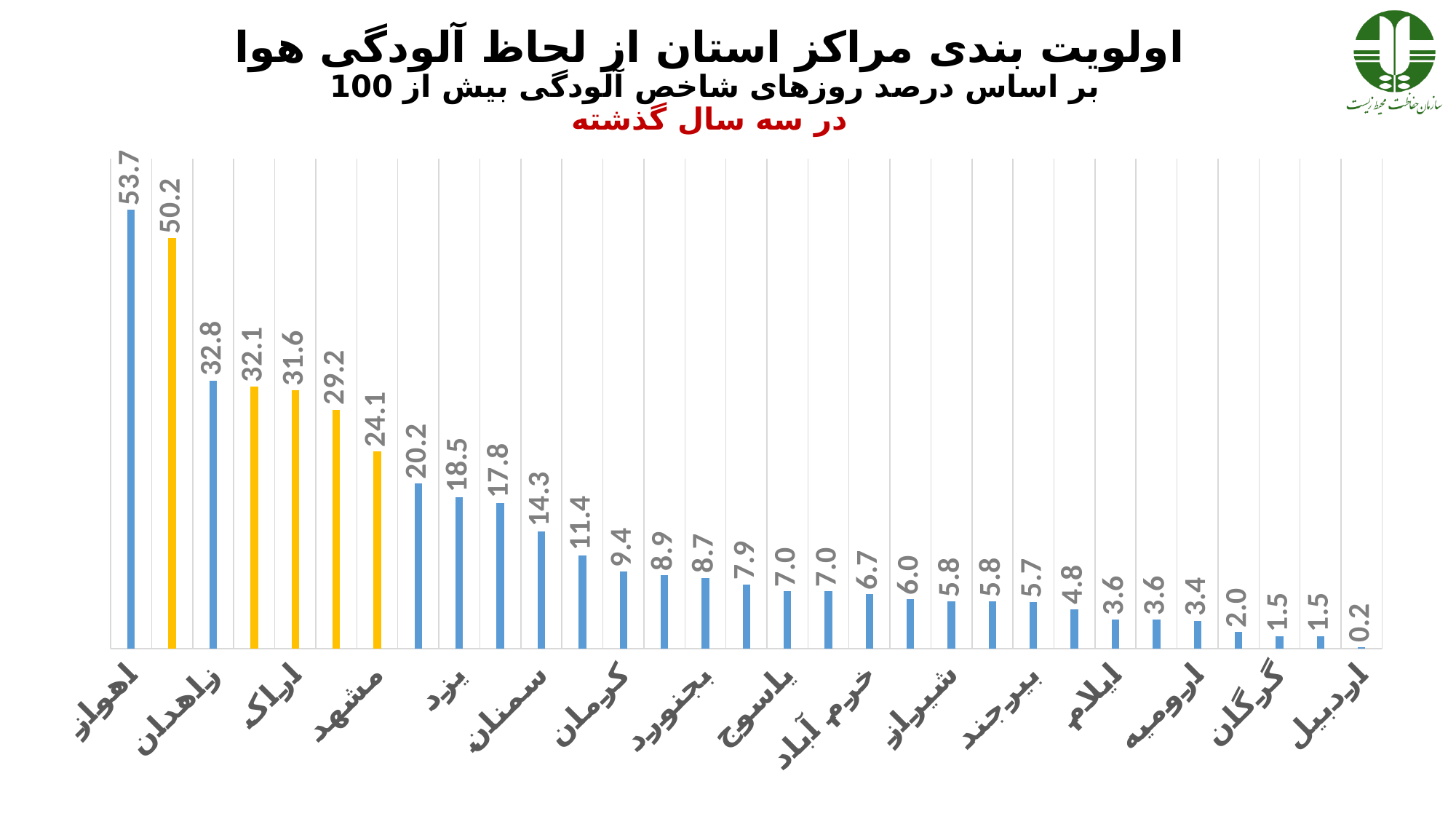
What is the value for مشهد? 24.1 What is the value for اردبیل? 0.2 Which has a larger value, اراک or سمنان? اراک Which city has the lowest value in the chart? اردبیل What is the value for یزد? 18.5 How many bars are plotted in the chart? 31 Which city has the highest value in the chart? اهواز What is the value for کرمان? 9.4 Do the values rise or fall moving from left to right along the x axis? fall What type of chart is shown on the slide? bar chart What is the value for اهواز? 53.7 What is the difference between the values for اهواز and زاهدان? 20.9